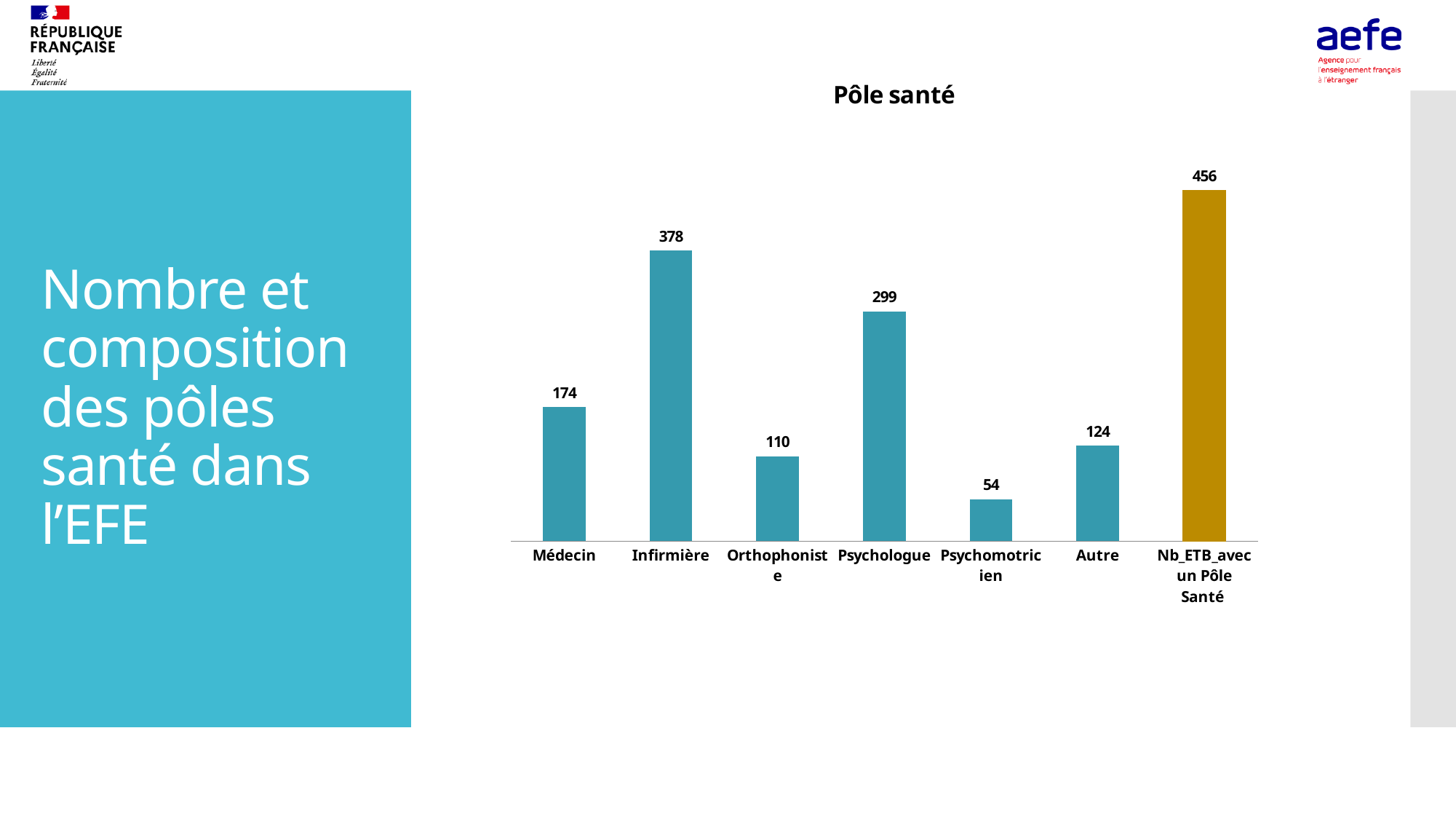
What is the value for Infirmière? 378 What kind of chart is this? Bar chart How many categories are shown on the chart? 7 What is the value for Psychomotricien? 54 What is the difference between the values for Médecin and Autre? 50 Which category has the highest value? Nb_ETB_avec un Pôle Santé What is the difference between the values for Infirmière and Psychologue? 79 What is the value for Nb_ETB_avec un Pôle Santé? 456 What is the title of the chart? Pôle santé Which is larger, the value for Médecin or the value for Orthophoniste? Médecin What is the value for Orthophoniste? 110 Which category has the lowest value? Psychomotricien